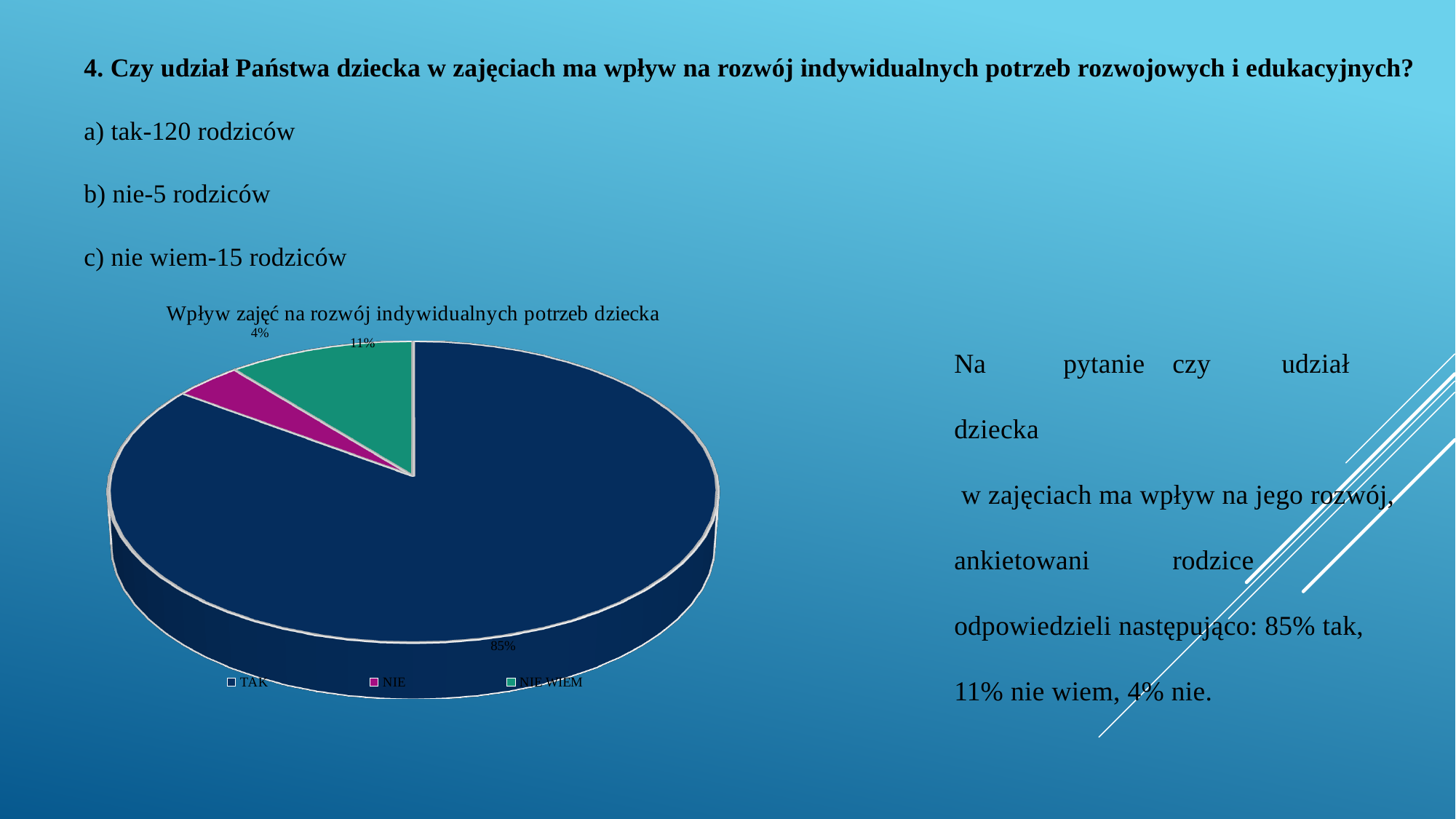
What share of the pie does TAK represent? 85% What share of the pie does NIE represent? 4% What share of the pie does NIE WIEM represent? 11% What is the difference in percentage points between the TAK share and the NIE WIEM share? 74 How many slices does the pie chart have? 3 What kind of chart is shown on the slide? pie chart Which category has the smallest slice of the pie? NIE Which is larger, the share for NIE WIEM or the share for NIE? NIE WIEM What colour is the TAK slice in the pie chart? dark blue Which category has the largest slice of the pie? TAK What is the title of the chart? Wpływ zajęć na rozwój indywidualnych potrzeb dziecka How many entries does the legend list? 3